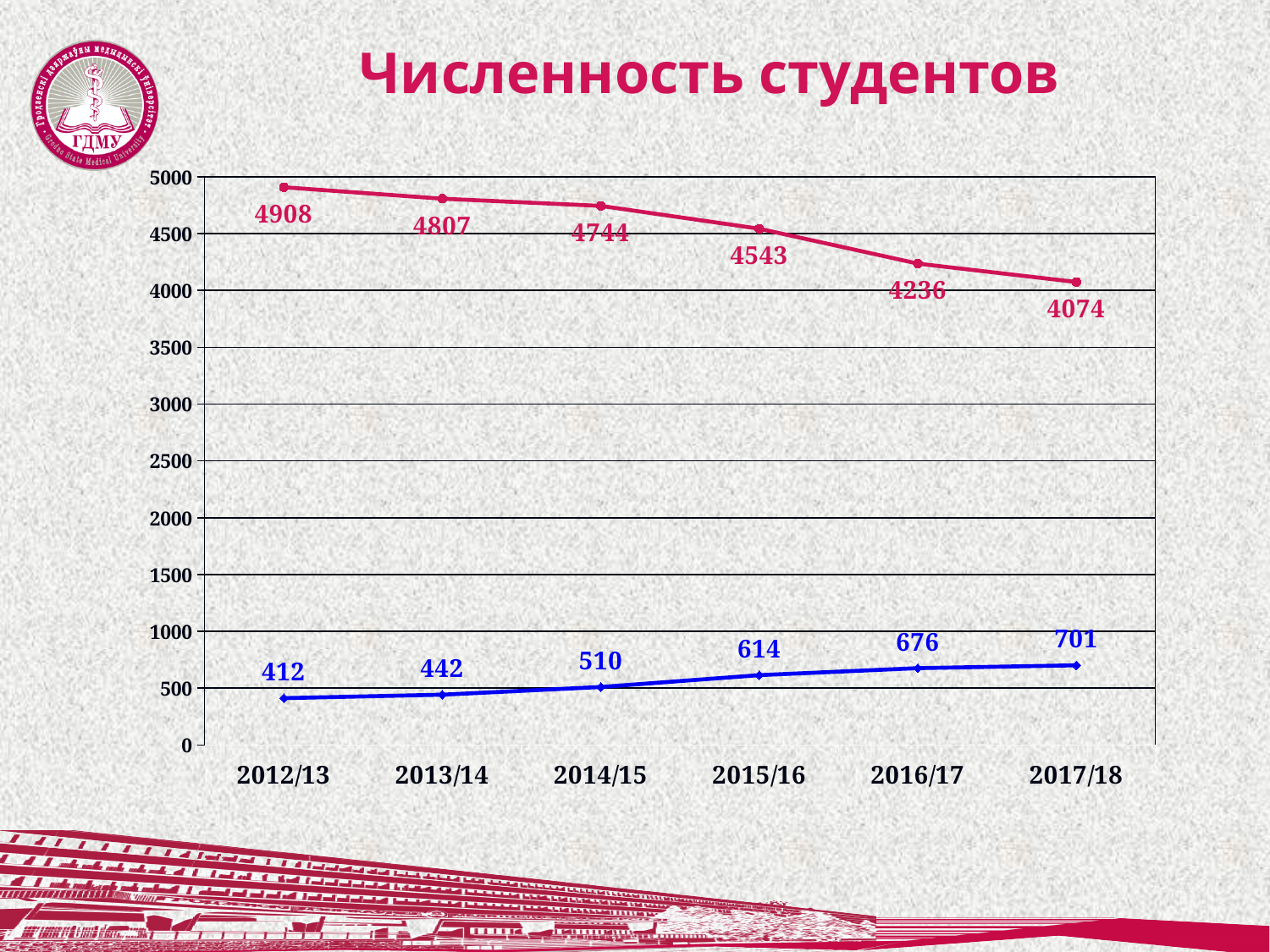
What is the title of the chart? Численность студентов How many academic years are shown on the x axis? 6 What is the value of the red line for 2012/13? 4908 What is the value of the blue line for 2015/16? 614 What is the difference between the red line values for 2012/13 and 2017/18? 834 Does the red line rise or fall from 2012/13 to 2017/18? fall Which is larger: the blue line value for 2013/14 or for 2014/15? 2014/15 What is the value of the red line for 2017/18? 4074 What is the difference between the blue line values for 2016/17 and 2017/18? 25 In which academic year does the red line have its lowest value? 2017/18 What kind of chart is shown on the slide? line chart In which academic year does the blue line reach its highest value? 2017/18